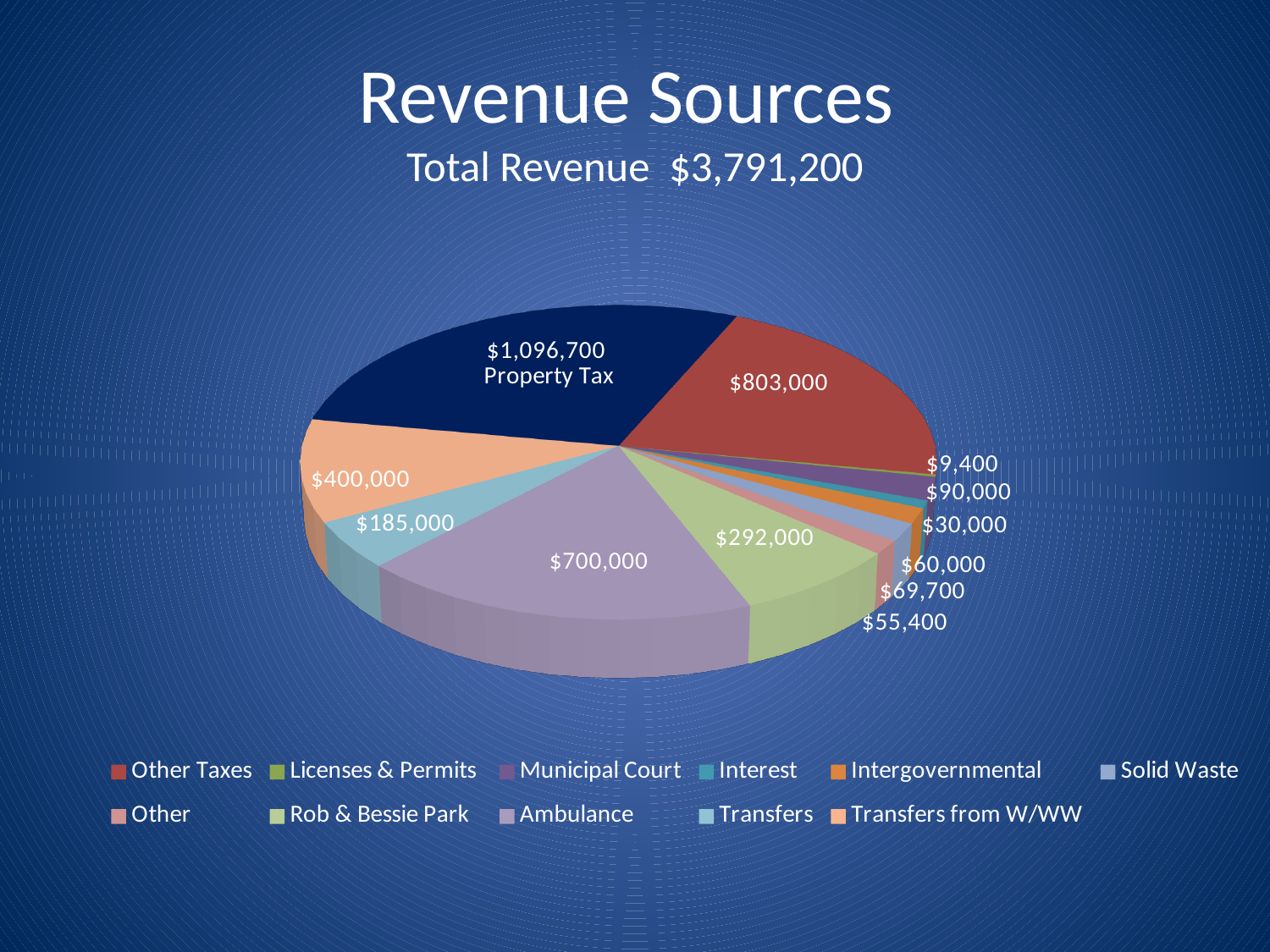
What is the value of the Property Tax slice? $1,096,700 What is the smallest value labelled on the pie chart? $9,400 Which revenue source has the largest slice of the pie? Property Tax What kind of chart is shown on the slide? Pie chart What is the difference between the Ambulance slice and the Transfers from W/WW slice? $300,000 What is the value of the Ambulance slice? $700,000 What is the value of the Transfers from W/WW slice? $400,000 Which is larger, the Ambulance slice or the Other Taxes slice? Other Taxes What is the value of the Rob & Bessie Park slice? $292,000 How much larger is the Property Tax slice than the Other Taxes slice? $293,700 What is the value of the Other Taxes slice (the red slice)? $803,000 How many slices does the pie chart have? 12